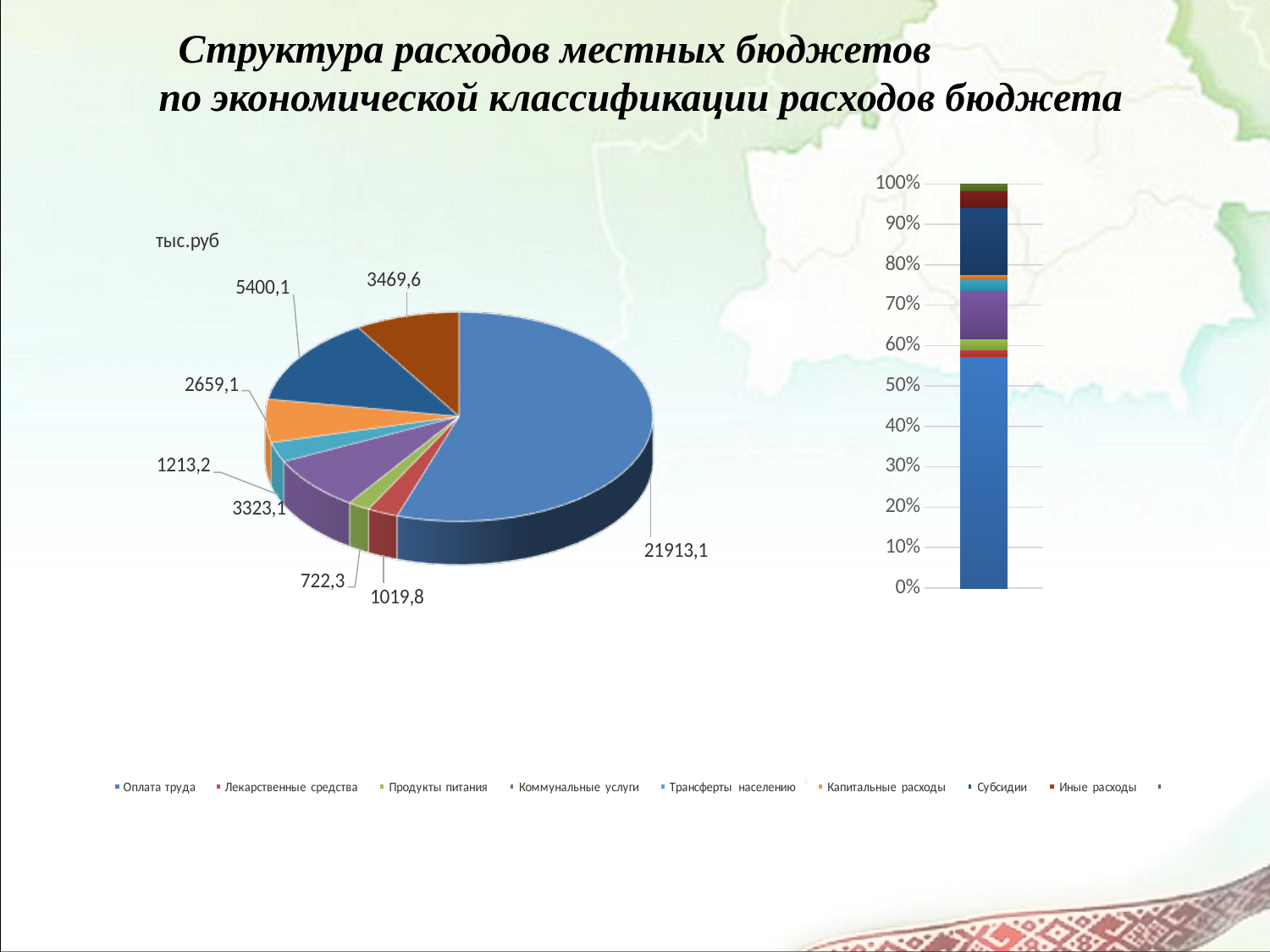
On the pie chart, what is the value for Коммунальные услуги? 3323,1 On the pie chart, which category has the smallest value? Продукты питания On the pie chart, which is larger: Капитальные расходы or Трансферты населению? Капитальные расходы How many slices does the pie chart have? 8 On the pie chart, what is the difference between the values for Субсидии and Иные расходы? 1930,5 On the pie chart, what is the value for Оплата труда? 21913,1 On the pie chart, which category has the largest value? Оплата труда On the pie chart, what is the value for Продукты питания? 722,3 What unit label is shown above the pie chart? тыс.руб On the pie chart, what is the value for Иные расходы? 3469,6 On the pie chart, what is the value for Субсидии? 5400,1 What kind of chart is the chart on the right side of the slide? Stacked bar chart